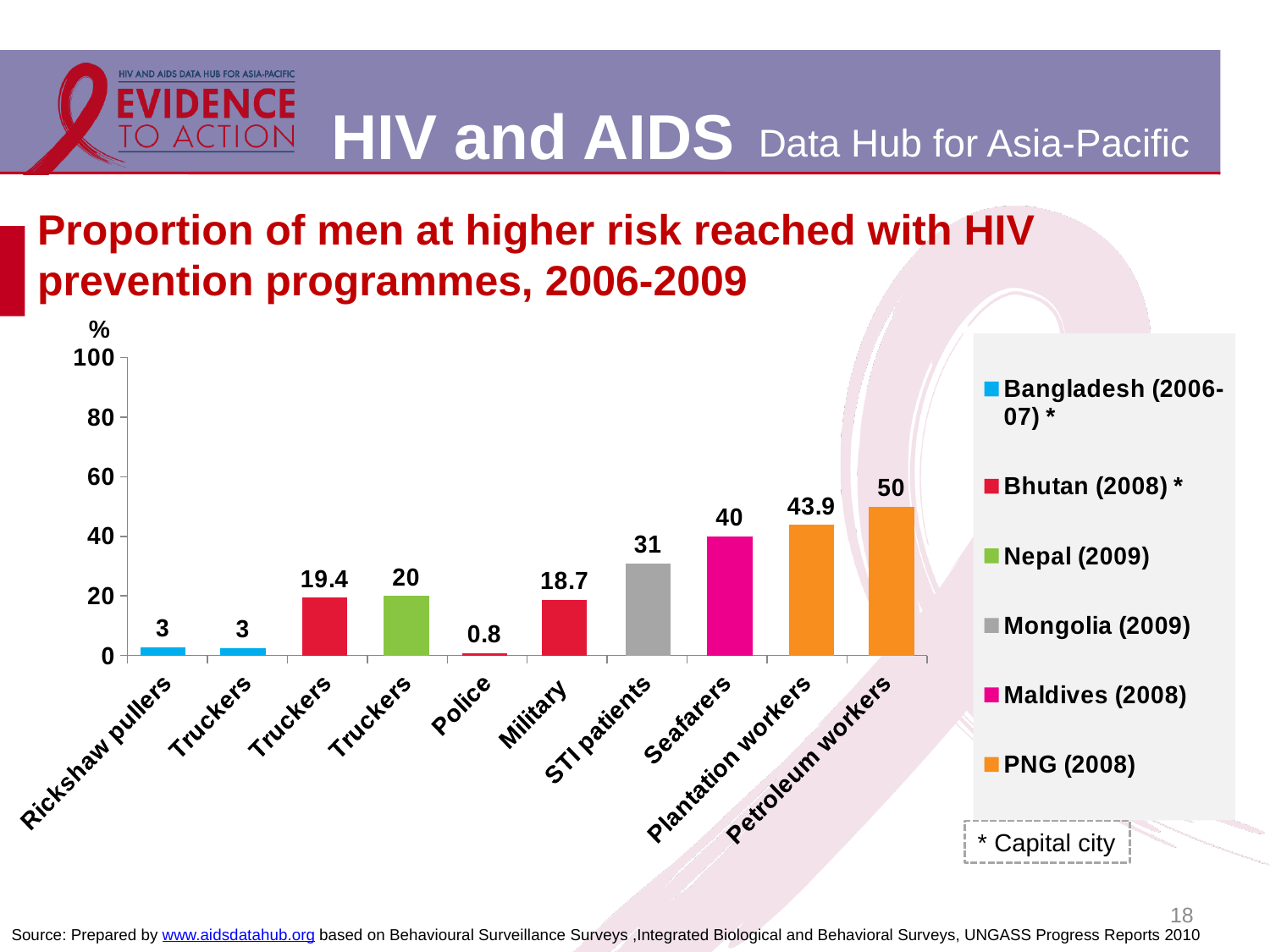
What kind of chart is shown on the slide? Bar chart Which is larger, the value for STI patients or the value for Military? STI patients What is the value for Rickshaw pullers? 3 What is the value for Petroleum workers? 50 Which country does the legend associate with the orange bars? PNG (2008) What is the difference between the values for Petroleum workers and Plantation workers? 6.1 How many series does the legend list? 6 Which category has the highest value? Petroleum workers Which category has the lowest value? Police What is the value for Police? 0.8 How many bars are plotted in the chart? 10 What is the value for Seafarers? 40